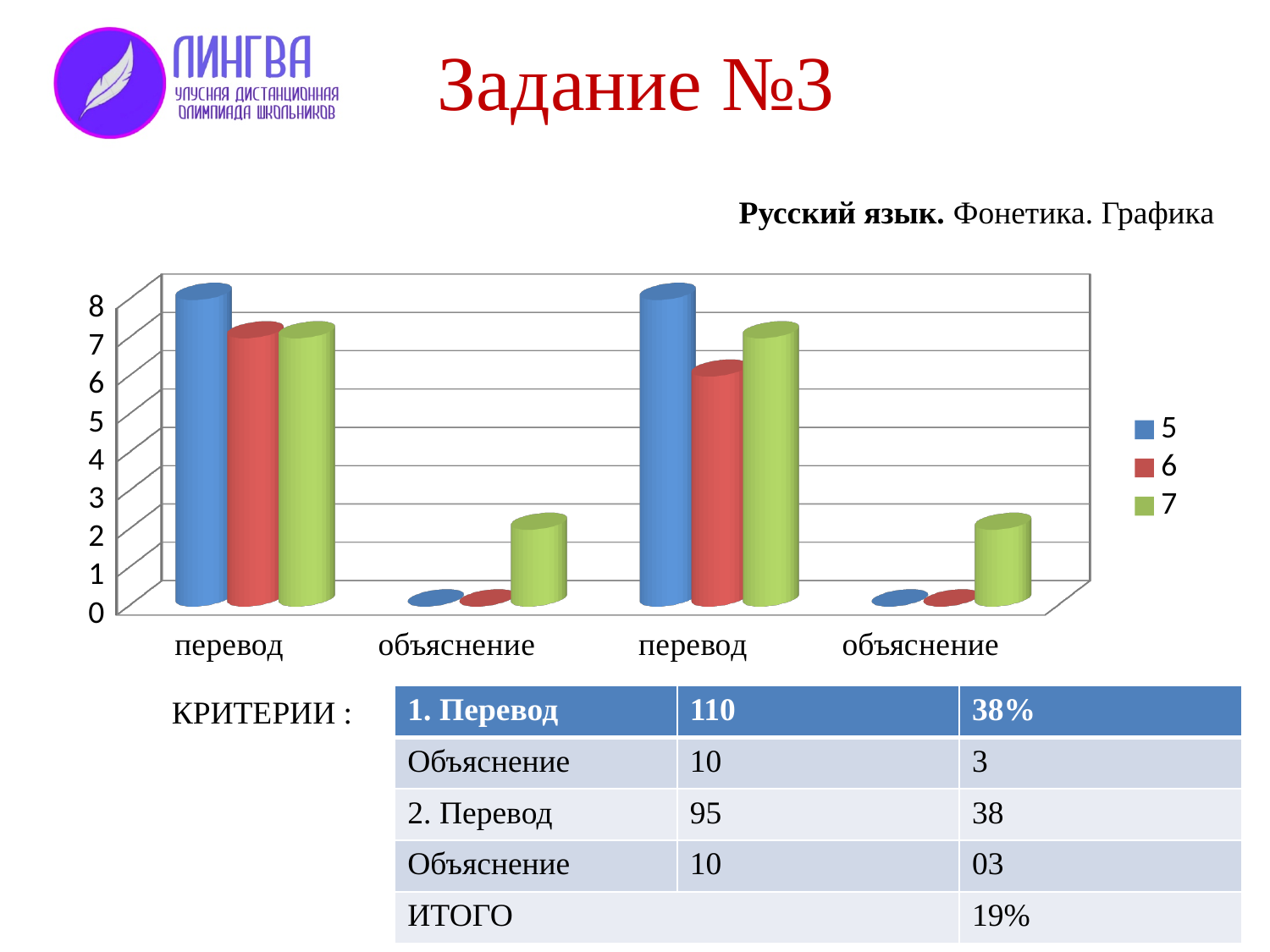
In the second перевод group, which series has the highest value? 5 In the first перевод group, is the value for series 5 greater or less than 4? greater How many series does the chart legend list? 3 What kind of chart is shown on the slide? bar chart What heading is written above the chart? Русский язык. Фонетика. Графика What are the entries in the chart legend? 5, 6, 7 In the second перевод group, is the value for series 6 greater or less than 4? greater How many category groups are shown along the x axis of the chart? 4 In the second перевод group, which series has the lowest value? 6 In the second перевод group, which is larger: the value for series 5 or series 6? series 5 In the first объяснение group, which is larger: the value for series 7 or series 5? series 7 In the first объяснение group, is the value for series 7 greater or less than 4? less